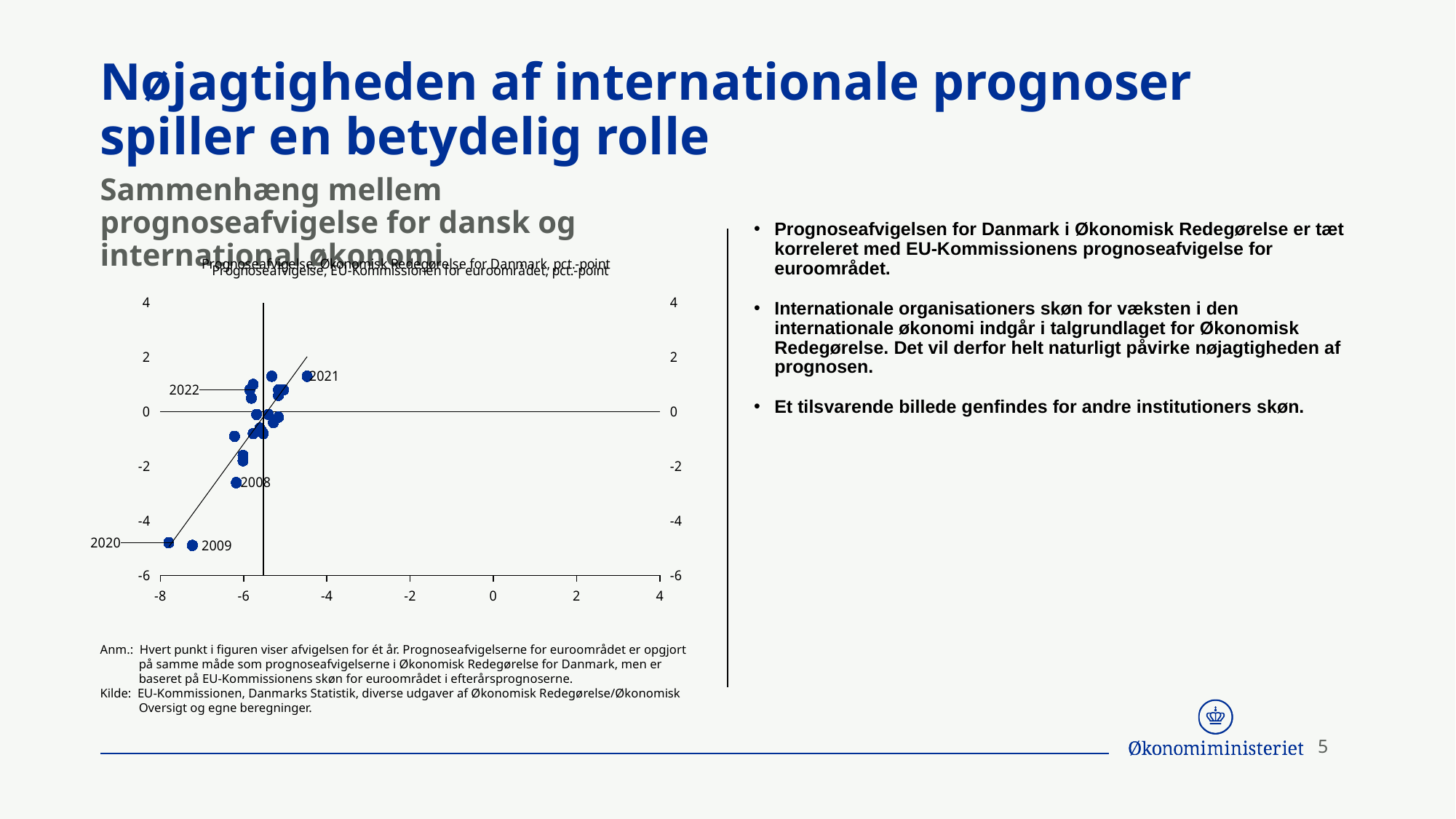
What kind of chart is shown on the slide? scatter chart Which labelled year lies furthest to the left on the horizontal axis? 2020 Which point has the lower vertical-axis value, 2020 or 2008? 2020 How many data points on the chart are labelled with a year? 5 Is the vertical-axis value for the point labelled 2008 greater or less than -2? less Which point has the higher vertical-axis value, 2021 or 2008? 2021 Is the vertical-axis value for the point labelled 2021 greater or less than 0? greater What is the title of the chart? Sammenhæng mellem prognoseafvigelse for dansk og international økonomi Which labelled year has the highest value on the vertical axis? 2021 Is the vertical-axis value for the point labelled 2020 greater or less than -4? less Do the points generally rise or fall as the horizontal-axis value increases? rise